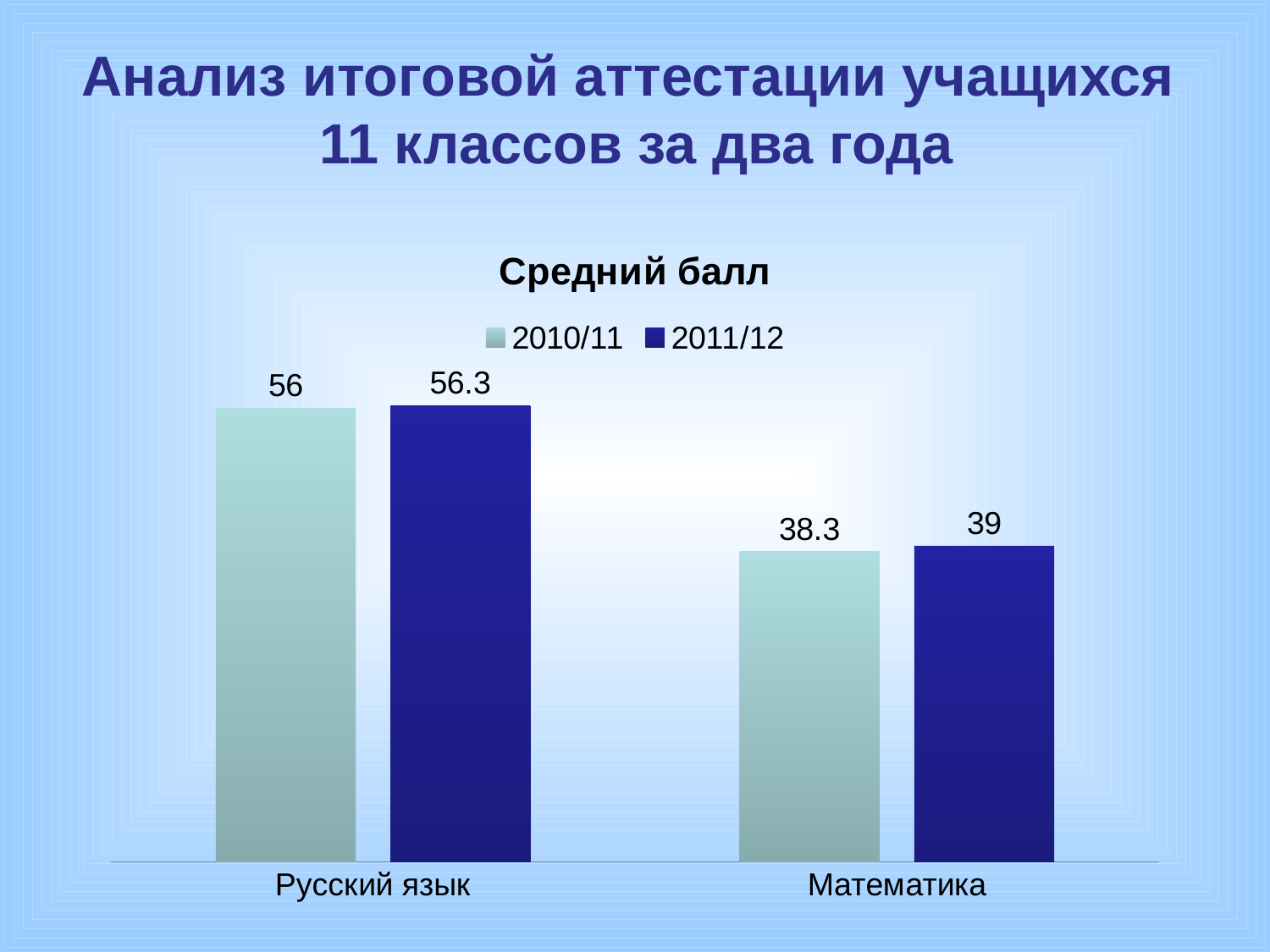
What is the average score for Русский язык in 2011/12? 56.3 What is the average score for Русский язык in 2010/11? 56 What is the difference between the Русский язык and Математика average scores in 2010/11? 17.7 How many subjects are shown on the x axis? 2 What type of chart is shown on the slide? Bar chart What is the average score for Математика in 2011/12? 39 What is the average score for Математика in 2010/11? 38.3 How many series does the legend list? 2 What is the difference between the 2011/12 and 2010/11 average scores for Математика? 0.7 Which subject has the lowest average score in 2010/11? Математика Which subject has the highest average score in 2011/12? Русский язык Which is larger: the 2010/11 score for Русский язык or the 2011/12 score for Математика? 2010/11 score for Русский язык